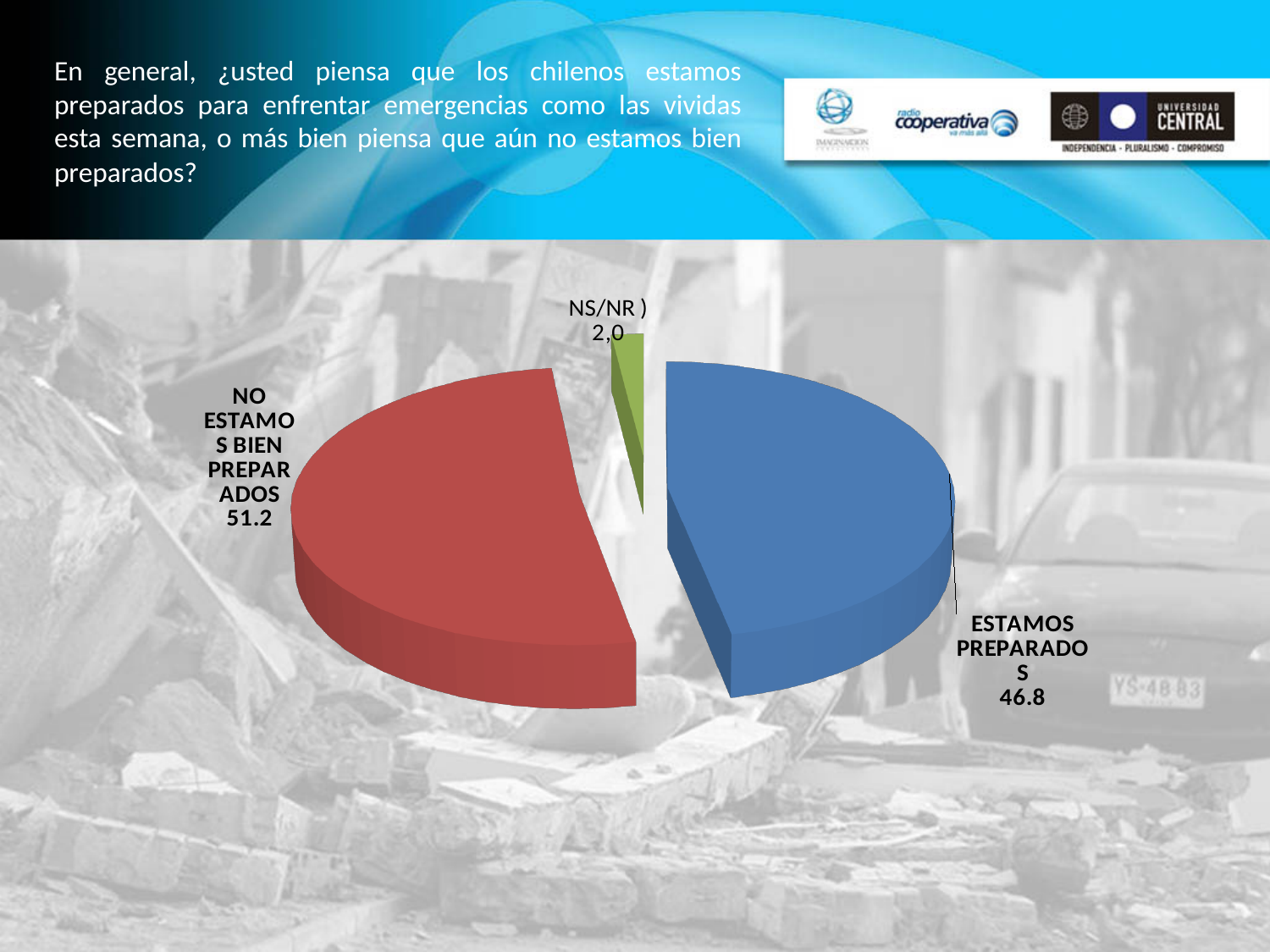
What colour is the slice for NO ESTAMOS BIEN PREPARADOS? red What is the value shown for the slice labelled ESTAMOS PREPARADOS? 46.8 What is the value shown for the slice labelled NO ESTAMOS BIEN PREPARADOS? 51.2 What colour is the slice for ESTAMOS PREPARADOS? blue Which is larger, the value for NS/NR or the value for ESTAMOS PREPARADOS? ESTAMOS PREPARADOS How many slices does the pie chart have? 3 Which slice of the pie chart is the largest? NO ESTAMOS BIEN PREPARADOS Which slice of the pie chart is the smallest? NS/NR What kind of chart is shown on the slide? pie chart What is the difference between the values for NO ESTAMOS BIEN PREPARADOS and ESTAMOS PREPARADOS? 4.4 What is the value shown for the NS/NR slice? 2,0 Which is larger, the value for ESTAMOS PREPARADOS or the value for NO ESTAMOS BIEN PREPARADOS? NO ESTAMOS BIEN PREPARADOS